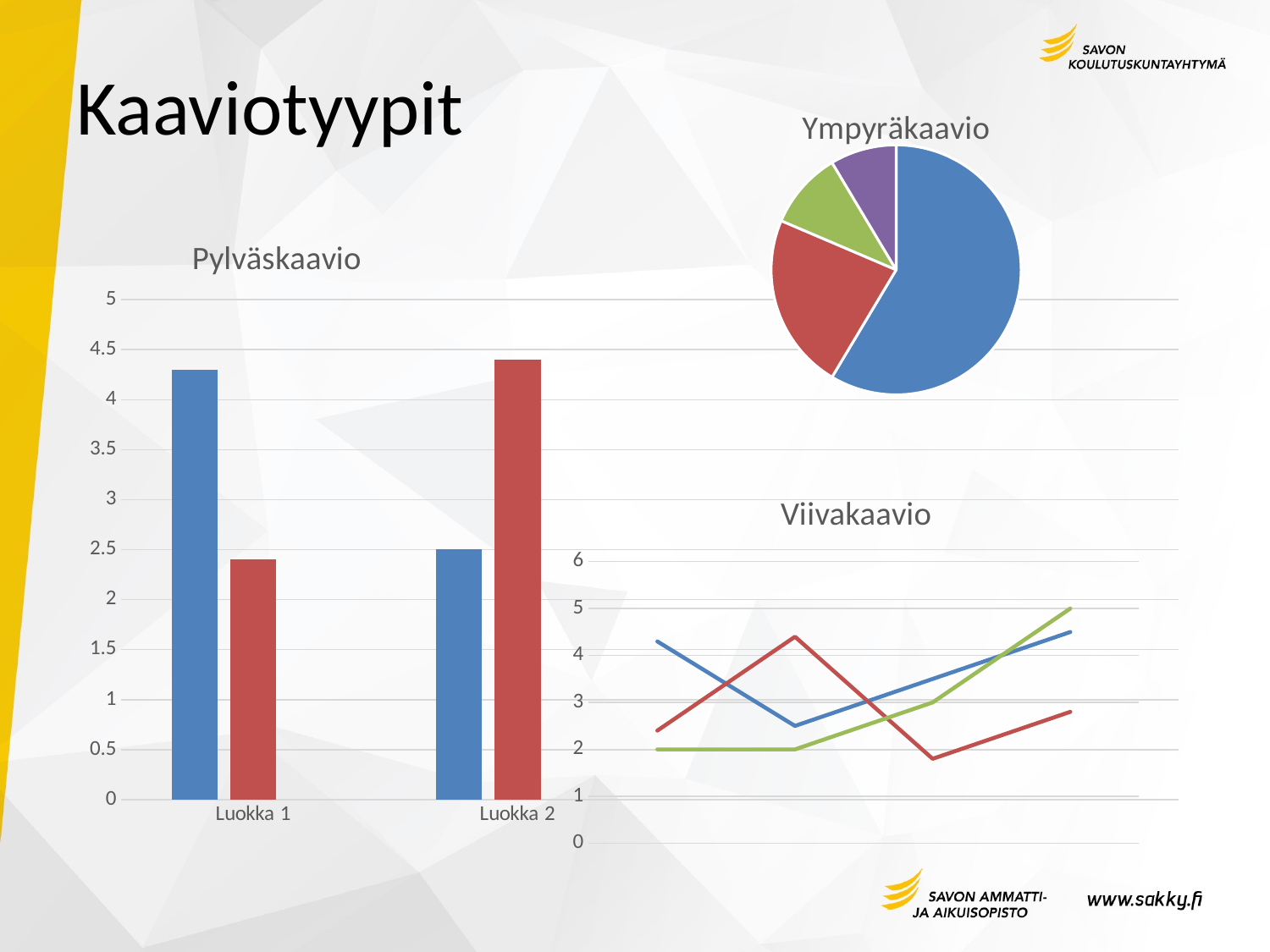
In the chart titled "Pylväskaavio", which bar is taller for Luokka 1, the blue bar or the red bar? the blue bar What kind of chart is the chart titled "Viivakaavio"? line chart In the chart titled "Pylväskaavio", is the value of the red bar for Luokka 2 greater or less than 4? greater What kind of chart is the chart titled "Ympyräkaavio"? pie chart In the chart titled "Pylväskaavio", how many categories are shown on the x axis? 2 What kind of chart is the chart titled "Pylväskaavio"? bar chart In the chart titled "Pylväskaavio", is the value of the red bar for Luokka 1 greater or less than 3? less In the chart titled "Viivakaavio", how many lines are plotted? 3 In the chart titled "Ympyräkaavio", how many slices does the pie have? 4 In the chart titled "Pylväskaavio", which bar is taller for Luokka 2, the blue bar or the red bar? the red bar In the chart titled "Pylväskaavio", is the value of the blue bar for Luokka 1 greater or less than 4? greater In the chart titled "Ympyräkaavio", which colour slice is the largest? blue